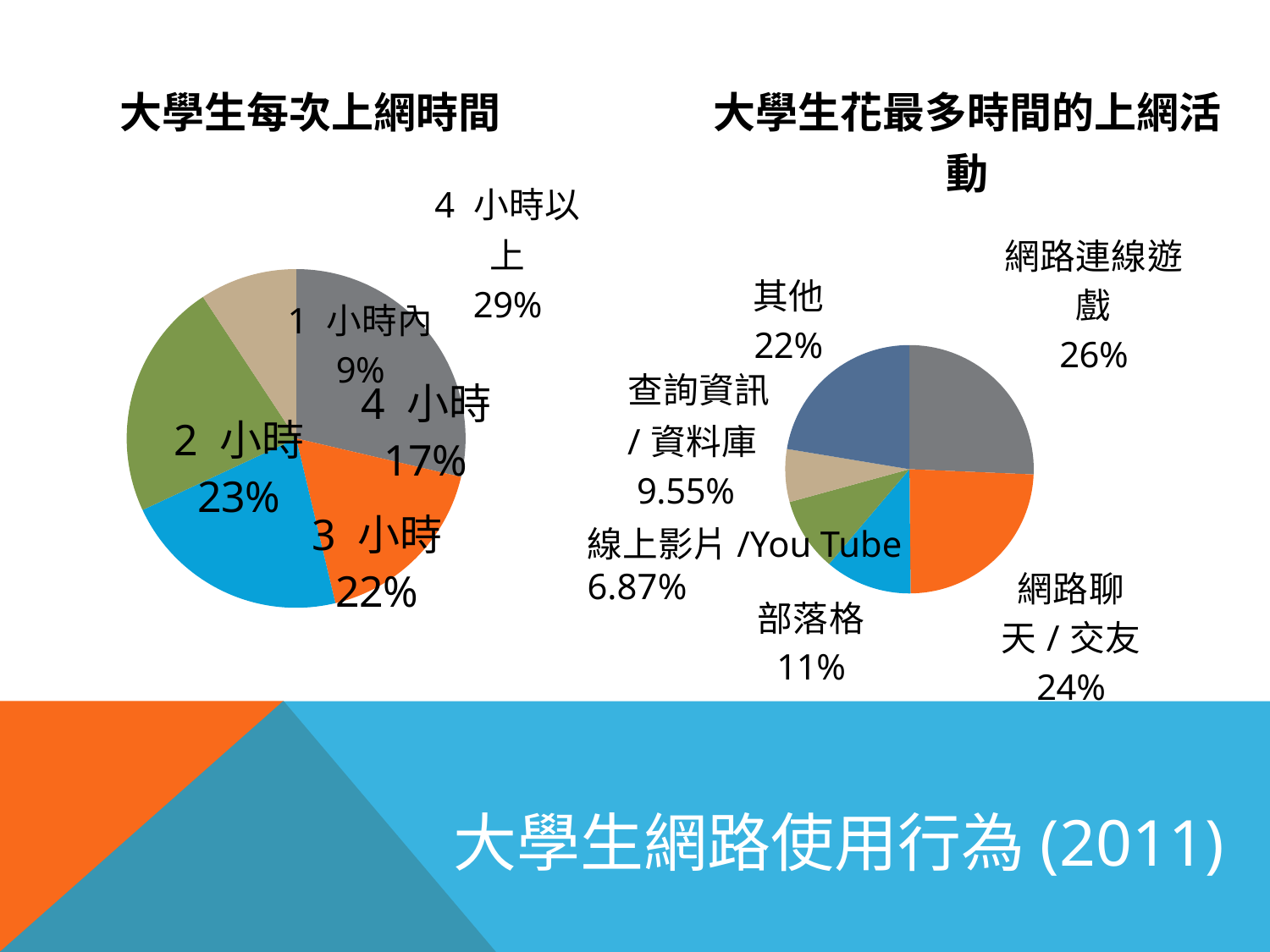
In the chart titled 大學生每次上網時間, which category has the smallest share? 1 小時內 In the chart titled 大學生每次上網時間, what percentage is shown for 4 小時以上? 29% In the chart titled 大學生每次上網時間, what is the difference between the shares for 2 小時 and 4 小時? 6% In the chart titled 大學生每次上網時間, which category has the largest share? 4 小時以上 In the chart titled 大學生每次上網時間, how many categories are shown? 5 In the chart titled 大學生花最多時間的上網活動, what percentage is shown for 線上影片 /You Tube? 6.87% In the chart titled 大學生花最多時間的上網活動, how many categories are shown? 6 In the chart titled 大學生花最多時間的上網活動, which is larger, 部落格 or 查詢資訊 / 資料庫? 部落格 What type of chart is used for 大學生花最多時間的上網活動? Pie chart In the chart titled 大學生花最多時間的上網活動, what percentage is shown for 網路聊天 / 交友? 24% In the chart titled 大學生花最多時間的上網活動, which activity has the largest share? 網路連線遊戲 In the chart titled 大學生每次上網時間, what percentage is shown for 1 小時內? 9%